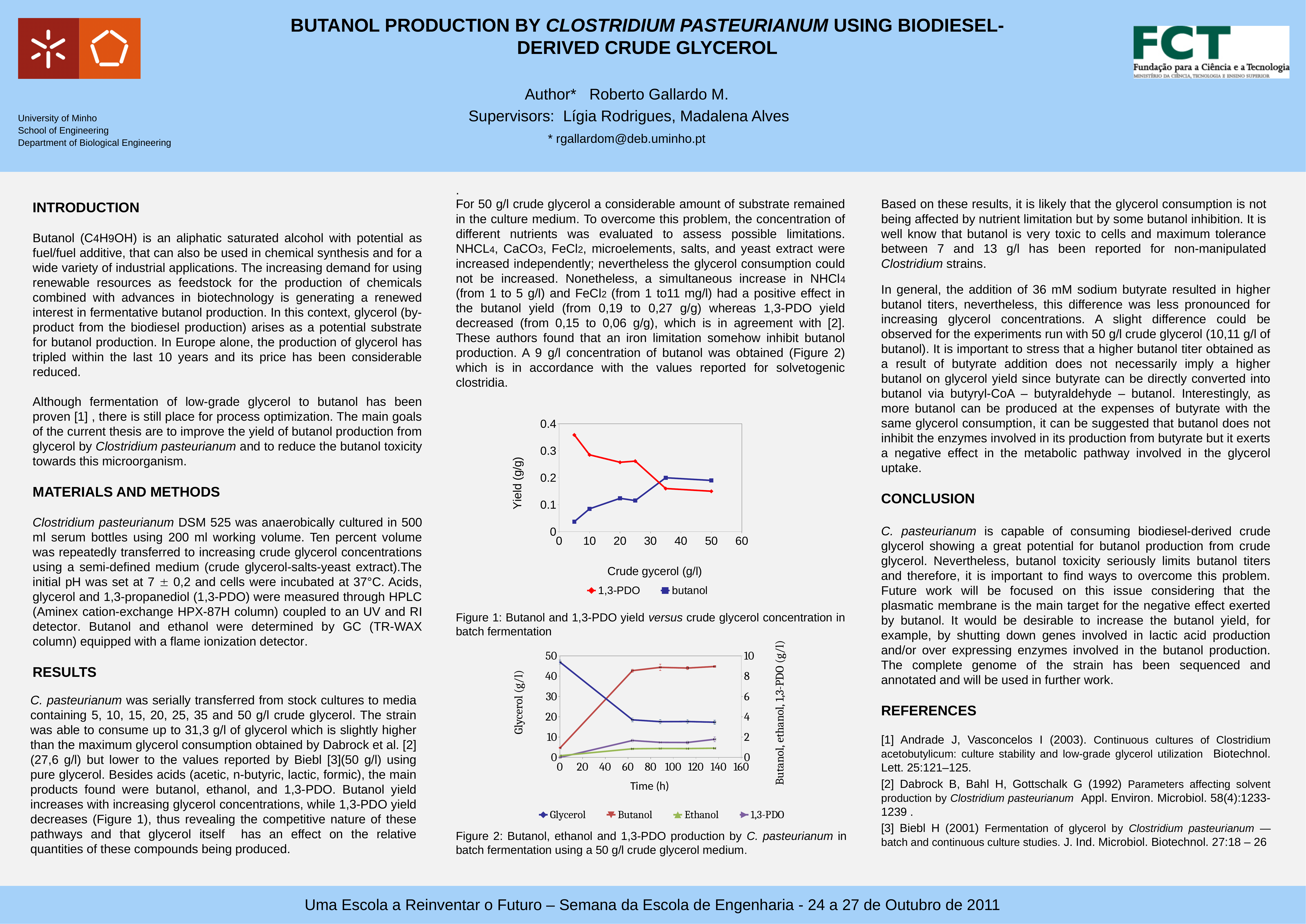
In Figure 1, does the 1,3-PDO yield rise or fall as crude glycerol concentration increases? fall How many series does the legend of Figure 1 list? 2 What kind of chart is Figure 1 (Butanol and 1,3-PDO yield versus crude glycerol concentration)? line chart What is the x-axis title of Figure 1? Crude gycerol (g/l) In Figure 1, is the butanol yield at the lowest crude glycerol concentration greater or less than 0.1 g/g? less In Figure 1, does the butanol yield rise or fall as crude glycerol concentration increases? rise How many series does the legend of Figure 2 (batch fermentation using 50 g/l crude glycerol) list? 4 In Figure 1, is the 1,3-PDO yield at the lowest crude glycerol concentration greater or less than 0.3 g/g? greater In Figure 2, is the glycerol concentration at time 0 greater or less than 40 g/l? greater In Figure 1, how many data points are plotted for the butanol series? 6 In Figure 2, does the glycerol concentration rise or fall over time? fall In Figure 2, at the final time point, which is larger: butanol or ethanol? Butanol